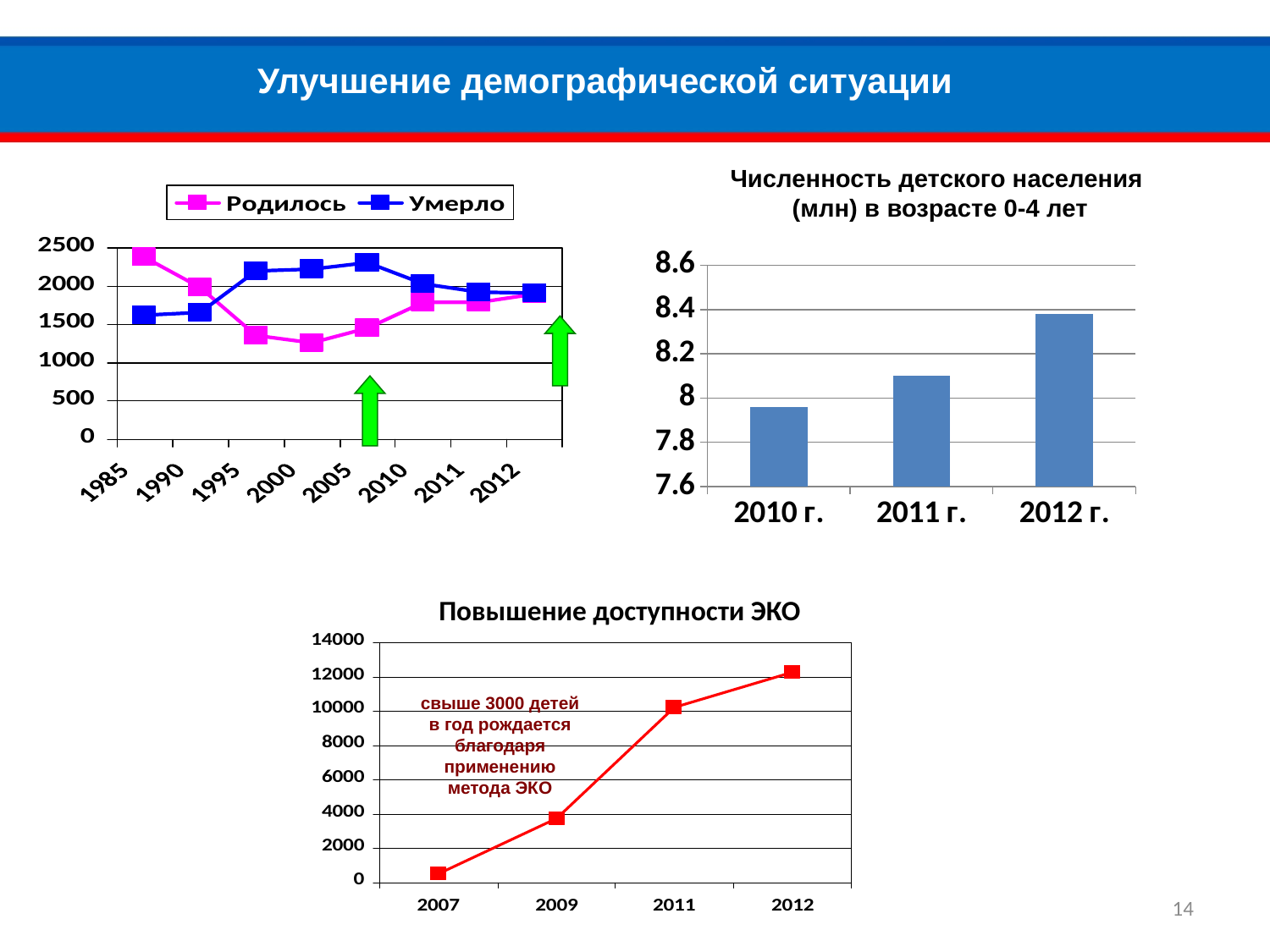
In the top-left chart, which series is higher in 2000, Родилось or Умерло? Умерло In the top-left chart, which series is higher in 1985, Родилось or Умерло? Родилось In the top-left chart, is the value for Родилось in 1985 greater or less than 2000? greater In the top-left chart, how many series does the legend list? 2 What kind of chart is 'Повышение доступности ЭКО'? line chart In the chart titled 'Численность детского населения (млн) в возрасте 0-4 лет', which year has the highest bar? 2012 г. In the top-left chart, in which year is the Родилось series at its lowest? 2000 In the chart titled 'Численность детского населения (млн) в возрасте 0-4 лет', is the value for 2010 г. greater or less than 8? less In the chart titled 'Численность детского населения (млн) в возрасте 0-4 лет', do the values rise or fall from 2010 to 2012? rise In the top-left chart, how many years are shown on the x axis? 8 In the chart titled 'Повышение доступности ЭКО', which year has the lowest value? 2007